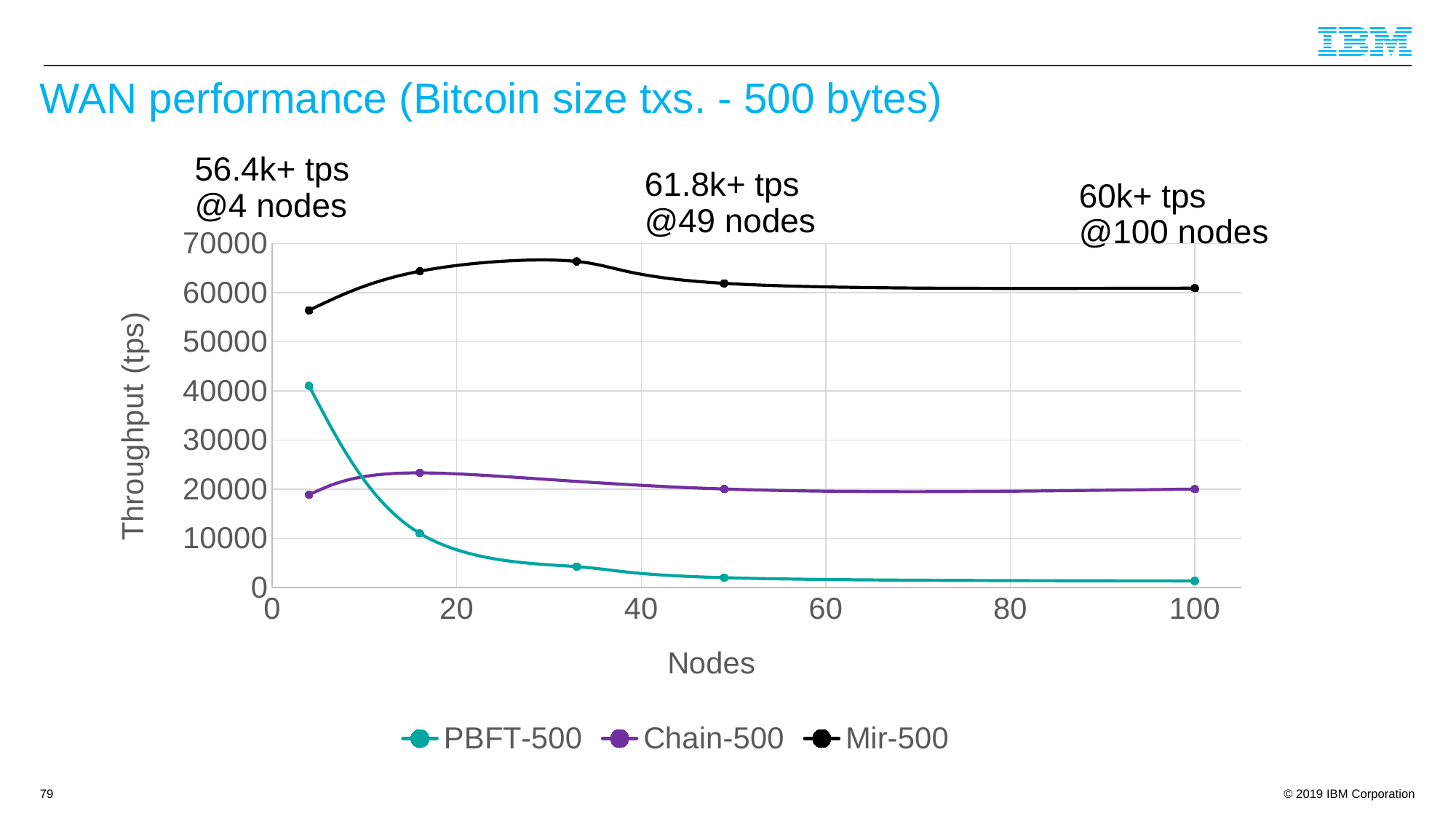
Does the throughput of PBFT-500 rise or fall as the number of nodes increases? fall What throughput does the annotation on the chart note at 49 nodes? 61.8k+ tps Is the throughput of Chain-500 at 100 nodes greater or less than 30000? less Is the throughput of PBFT-500 at 4 nodes greater or less than 30000? greater How many series does the legend list? 3 At 4 nodes, which has the higher throughput: PBFT-500 or Chain-500? PBFT-500 Which series has the lowest throughput at 100 nodes? PBFT-500 What is the label of the y axis? Throughput (tps) What kind of chart is shown on the slide? line chart Which series has the highest throughput at 100 nodes? Mir-500 How many data points are plotted for the Mir-500 series? 5 Is the throughput of Mir-500 at 4 nodes greater or less than 50000? greater